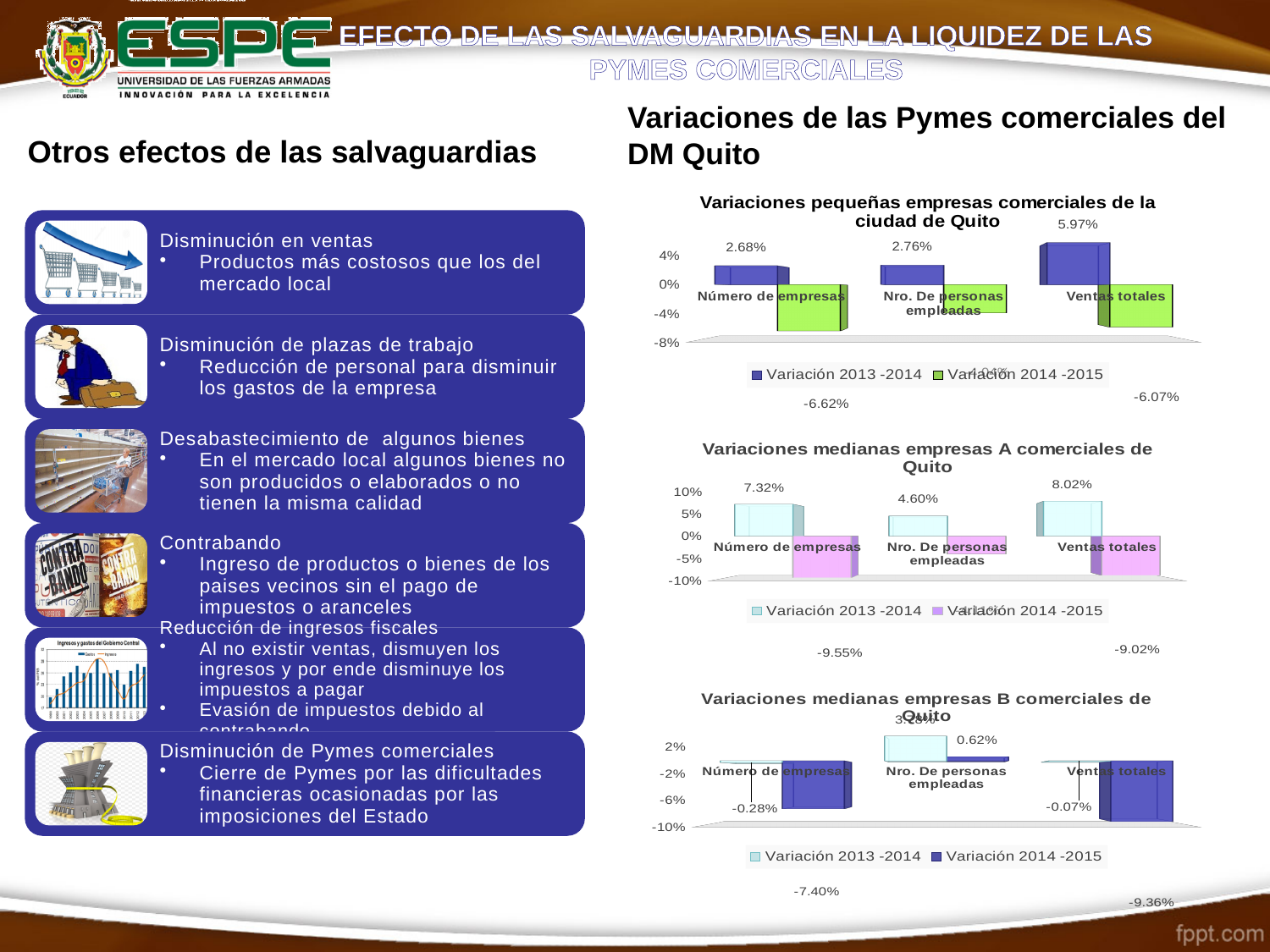
In the chart 'Variaciones medianas empresas B comerciales de Quito', what is the Variación 2013-2014 value for Número de empresas? -0.28% In the chart 'Variaciones medianas empresas A comerciales de Quito', what is the Variación 2013-2014 value for Nro. De personas empleadas? 4.60% In the chart 'Variaciones medianas empresas B comerciales de Quito', what is the Variación 2014-2015 value for Ventas totales? -9.36% In the chart 'Variaciones pequeñas empresas comerciales de la ciudad de Quito', what is the Variación 2014-2015 value for Número de empresas? -6.62% In the chart 'Variaciones pequeñas empresas comerciales de la ciudad de Quito', which category has the highest Variación 2013-2014 value? Ventas totales In the chart 'Variaciones pequeñas empresas comerciales de la ciudad de Quito', what is the difference between the Variación 2013-2014 values for Ventas totales and Número de empresas? 3.29% In the chart 'Variaciones pequeñas empresas comerciales de la ciudad de Quito', what is the Variación 2013-2014 value for Ventas totales? 5.97% In the chart 'Variaciones medianas empresas A comerciales de Quito', which category has the lowest Variación 2013-2014 value? Nro. De personas empleadas In the chart 'Variaciones medianas empresas B comerciales de Quito', which is larger: the Variación 2014-2015 value for Número de empresas or for Nro. De personas empleadas? Nro. De personas empleadas What kind of chart is 'Variaciones pequeñas empresas comerciales de la ciudad de Quito'? Bar chart How many series does the legend list in the chart 'Variaciones medianas empresas A comerciales de Quito'? 2 In the chart 'Variaciones medianas empresas A comerciales de Quito', what is the Variación 2014-2015 value for Ventas totales? -9.02%